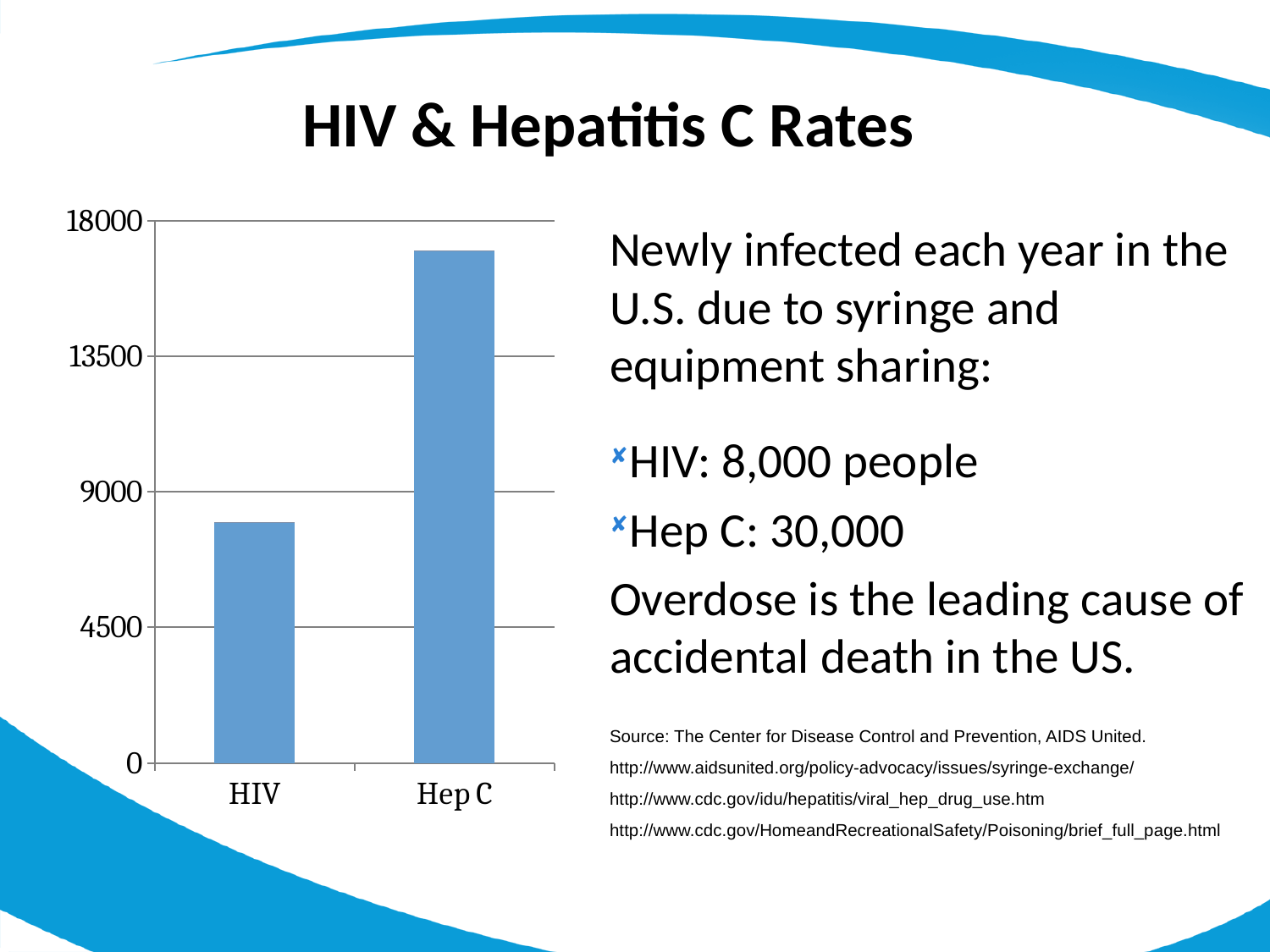
What kind of chart is shown on the slide? bar chart Is the value for HIV greater or less than 9000? less Which category has the highest bar in the chart? Hep C Is the value for Hep C greater or less than 13500? greater What are the two category labels on the horizontal axis of the chart? HIV and Hep C What is the highest value shown on the vertical axis of the chart? 18000 Which category has the lowest bar in the chart? HIV How many categories are plotted in the chart? 2 Which bar is taller, HIV or Hep C? Hep C Is the value for Hep C greater or less than 18000? less